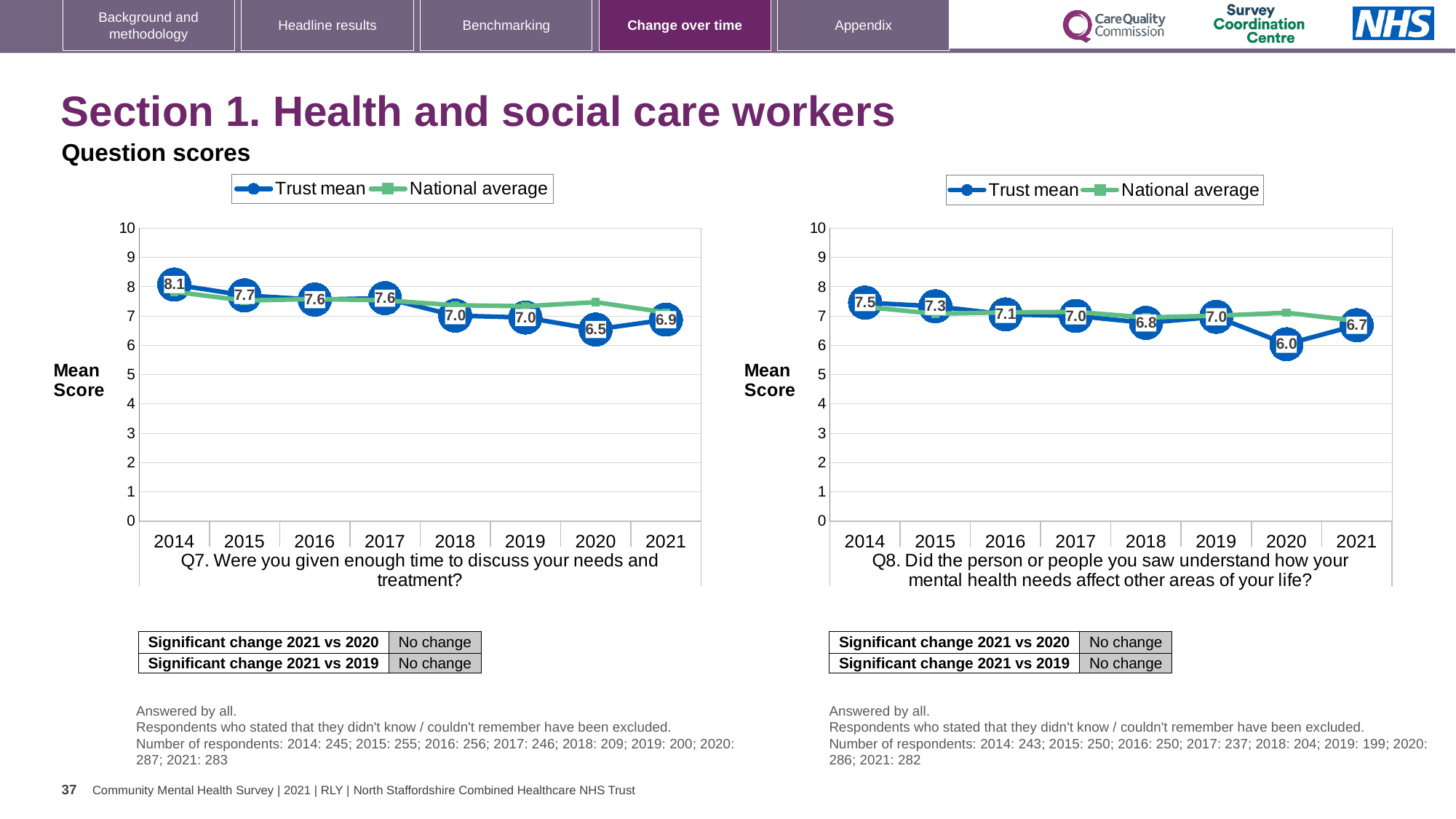
In the Q8 chart, which year has the lowest Trust mean? 2020 How many series does the legend of the Q7 chart list? 2 How many years are shown on the x axis of the Q8 chart? 8 In the Q7 chart, what is the Trust mean for 2014? 8.1 In the Q7 chart, is the National average for 2020 greater or less than 7? greater In the Q8 chart, what is the Trust mean for 2021? 6.7 In the Q7 chart, which year has the highest Trust mean? 2014 In the Q7 chart, what is the difference between the Trust mean in 2014 and in 2021? 1.2 In the Q8 chart, what is the difference between the Trust mean in 2019 and in 2020? 1.0 What kind of chart is used for Q7? Line chart In the Q8 chart, which is larger, the Trust mean for 2015 or for 2018? 2015 In the Q7 chart, what is the Trust mean for 2020? 6.5